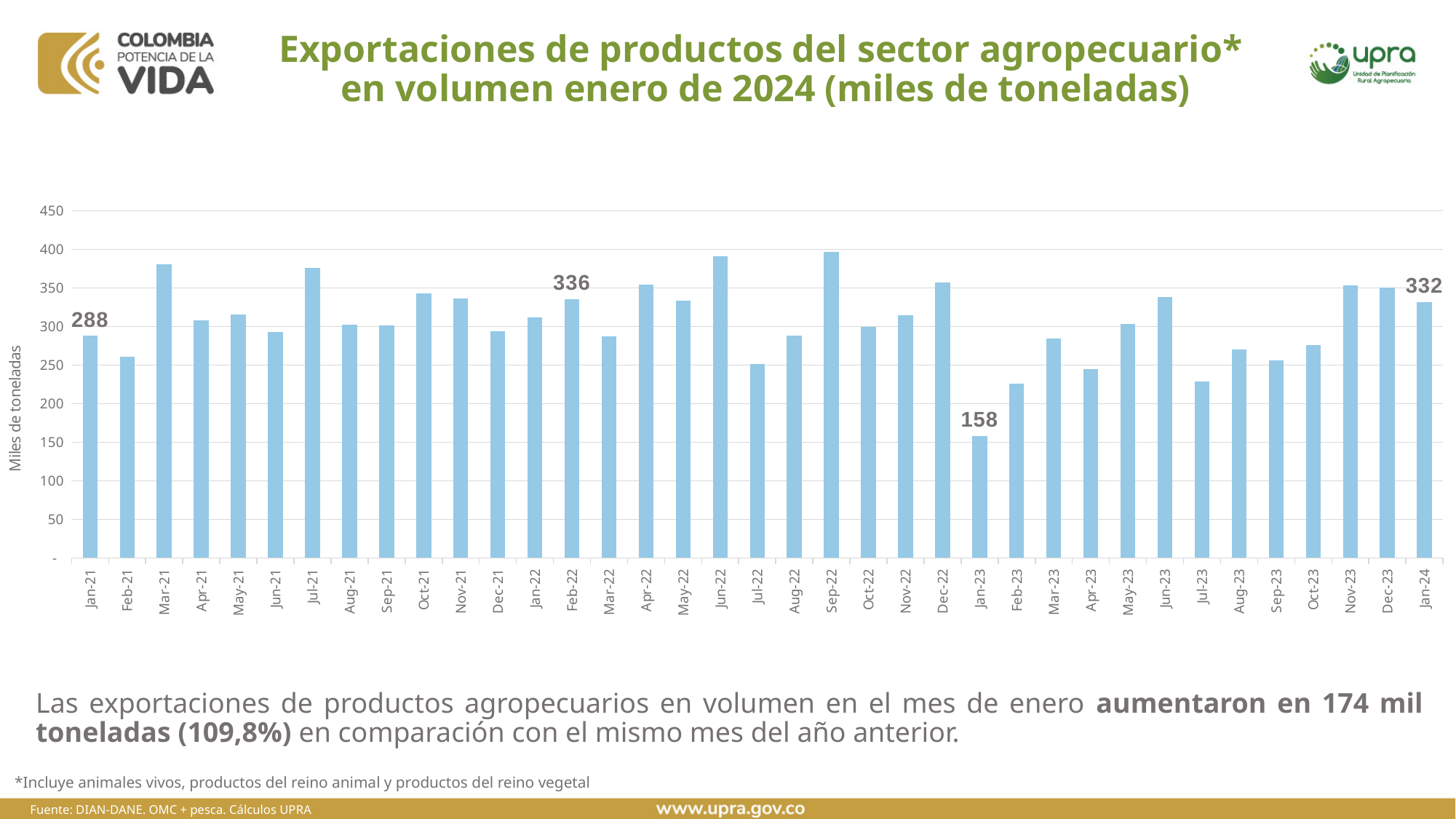
Which is larger, the value for Feb-22 or the value for Jan-21? Feb-22 What kind of chart is shown on the slide? Bar chart What is the difference between the values for Jan-24 and Jan-23? 174 How many monthly bars are plotted in the chart? 37 Is the value for Jul-22 greater or less than 300? less What is the value for Jan-24? 332 What is the value for Feb-22? 336 What is the value for Jan-23? 158 Is the value for Mar-21 greater or less than 350? greater Which month has the lowest value in the chart? Jan-23 What is the difference between the values for Jan-24 and Jan-21? 44 What is the value for Jan-21? 288